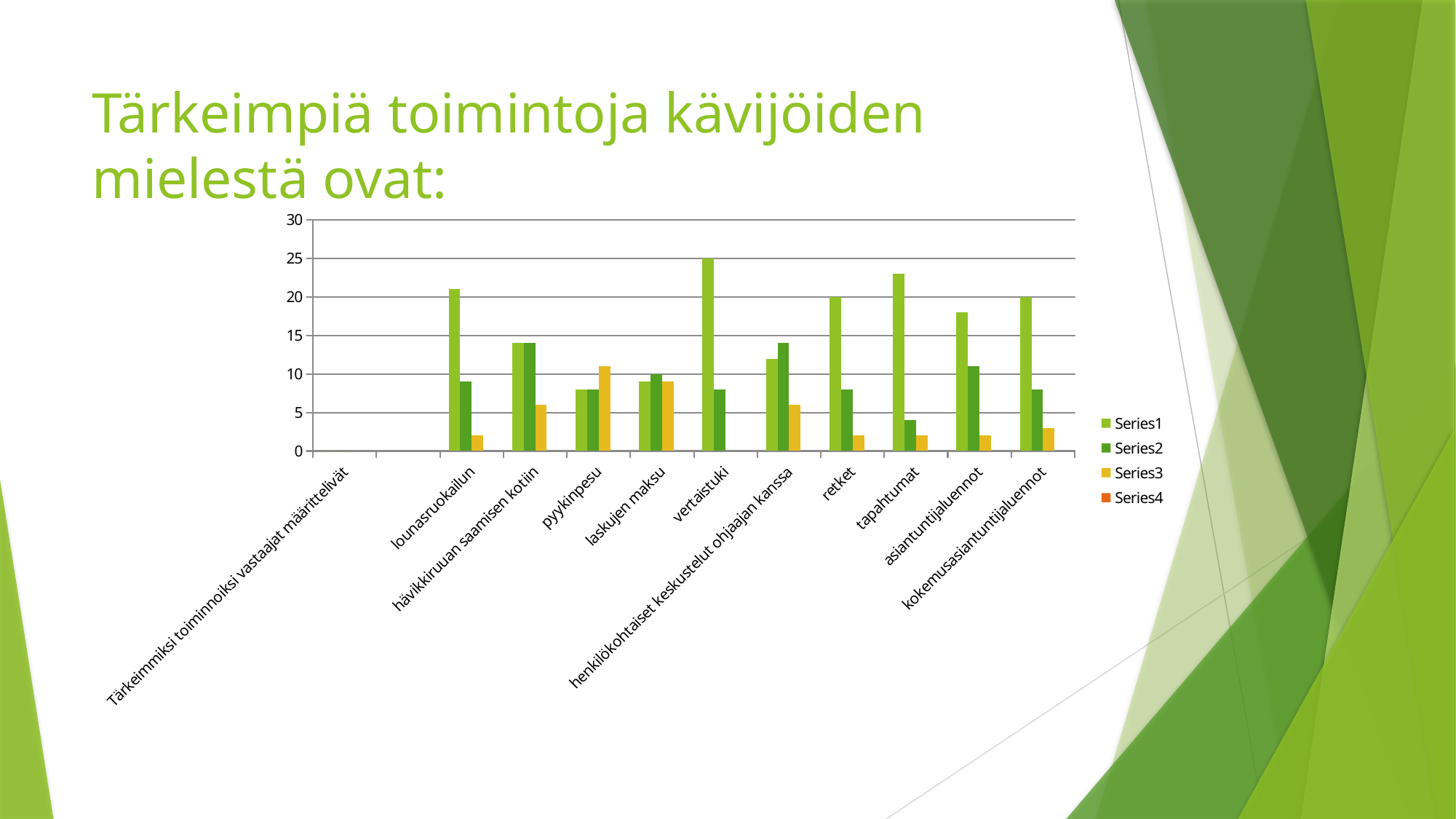
What is the Series2 value for laskujen maksu? 10 Is the Series1 value for asiantuntijaluennot greater or less than 20? less Is the Series1 value for tapahtumat greater or less than 20? greater How many categories are shown on the x axis? 11 What kind of chart is shown on the slide? bar chart For lounasruokailun, which is larger: the Series1 value or the Series2 value? Series1 How many series does the legend list? 4 What is the Series1 value for retket? 20 Which category has the highest Series1 value? vertaistuki Is the Series1 value for lounasruokailun greater or less than 20? greater What is the Series1 value for vertaistuki? 25 Which category has the highest Series3 value? pyykinpesu